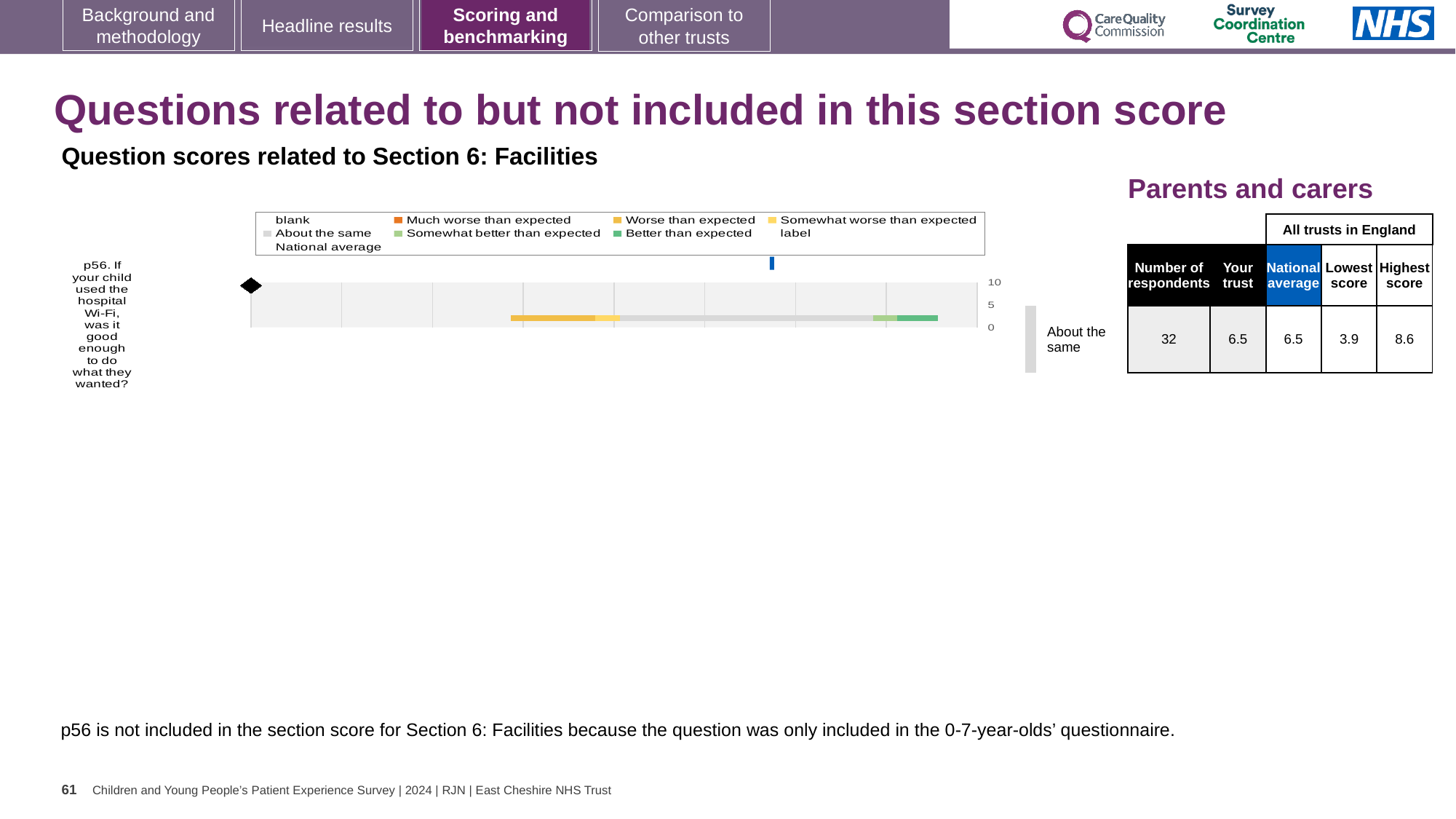
What is the highest value shown on the chart's numeric axis? 10 According to the table beside the chart, what is the 'Your trust' score for p56? 6.5 What kind of chart is used to show the p56 question score? bar chart Which is larger for p56 in the table beside the chart, the Highest score or the National average? Highest score How many questions (categories) are plotted in the chart? 1 According to the table beside the chart, what is the Lowest score among all trusts in England for p56? 3.9 According to the table beside the chart, what is the National average score for p56? 6.5 What is the question number of the single item plotted in the chart? p56 What is the difference between the Highest score and the Lowest score for p56 shown in the table beside the chart? 4.7 According to the table beside the chart, how many respondents answered p56? 32 According to the table beside the chart, what is the Highest score among all trusts in England for p56? 8.6 Which legend entry is shown in grey in the chart? About the same